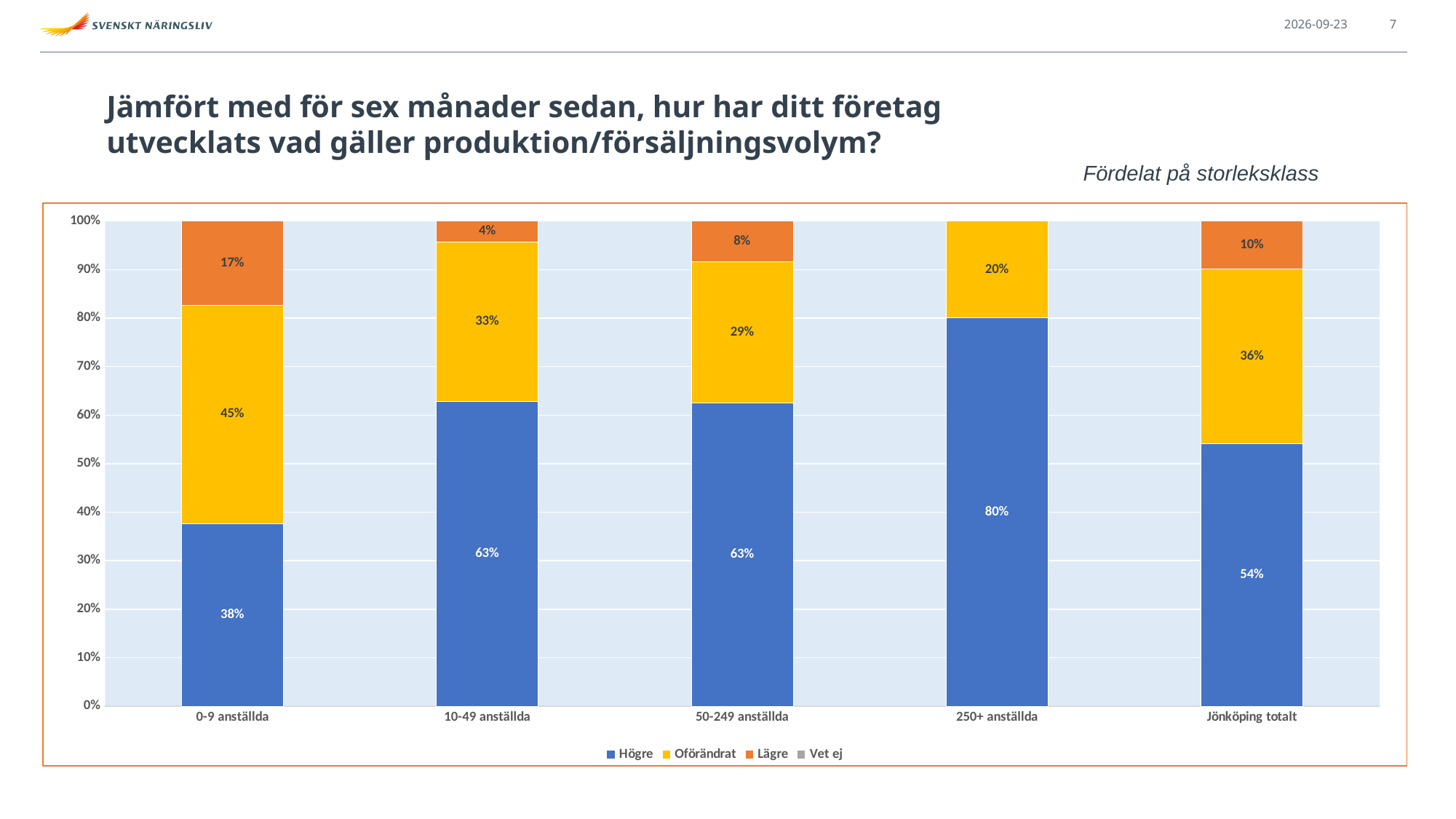
Which legend entry is shown in orange? Lägre How many categories are shown on the x axis? 5 What is the difference between the Lägre values for 0-9 anställda and 10-49 anställda? 13% What is the value of Lägre for 50-249 anställda? 8% What kind of chart is shown on the slide? Stacked bar chart What is the value of Oförändrat for 10-49 anställda? 33% What is the value of Högre for Jönköping totalt? 54% What is the value of Högre for 0-9 anställda? 38% How many series does the legend list? 4 Which is larger, the Oförändrat value for 0-9 anställda or for Jönköping totalt? 0-9 anställda Which category has the lowest value for Oförändrat? 250+ anställda Which category has the highest value for Högre? 250+ anställda